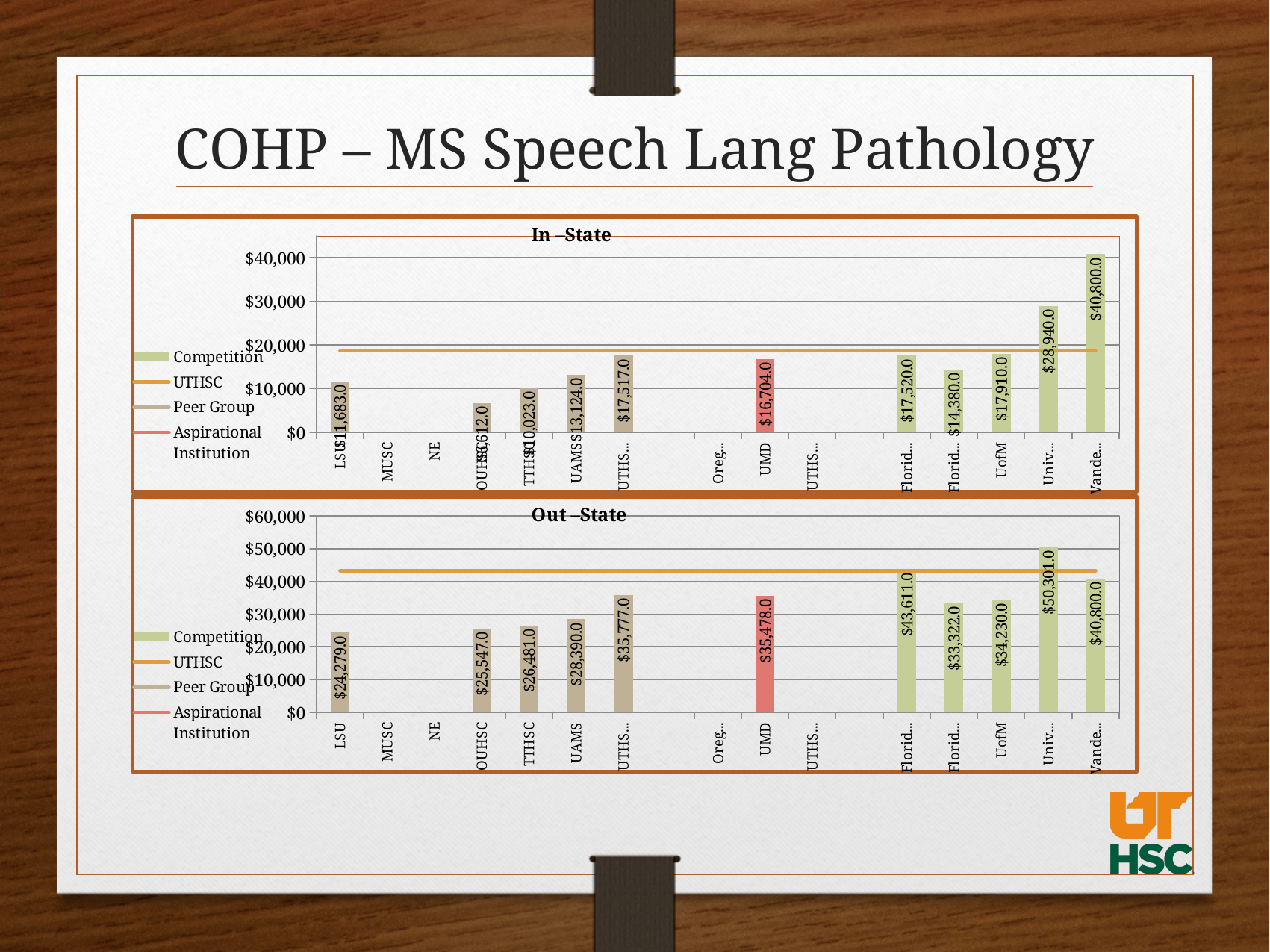
In the In-State chart, is the value for UMD greater or less than $20,000? less In the Out-State chart, what is the value of the tallest bar? $50,301.0 In the In-State chart, which is larger, the value for LSU or the value for TTHSC? LSU In the In-State chart, what is the value of the tallest bar? $40,800.0 In the Out-State chart, what is the value for UMD? $35,478.0 What kind of chart is the In-State chart? bar chart How many entries does the legend of the Out-State chart list? 4 In the In-State chart, what is the value for UofM? $17,910.0 What is the difference between the UAMS value in the Out-State chart and the UAMS value in the In-State chart? $15,266.0 In the In-State chart, what is the value for LSU? $11,683.0 In the Out-State chart, what is the value for UAMS? $28,390.0 In the Out-State chart, what is the difference between the TTHSC and OUHSC values? $934.0